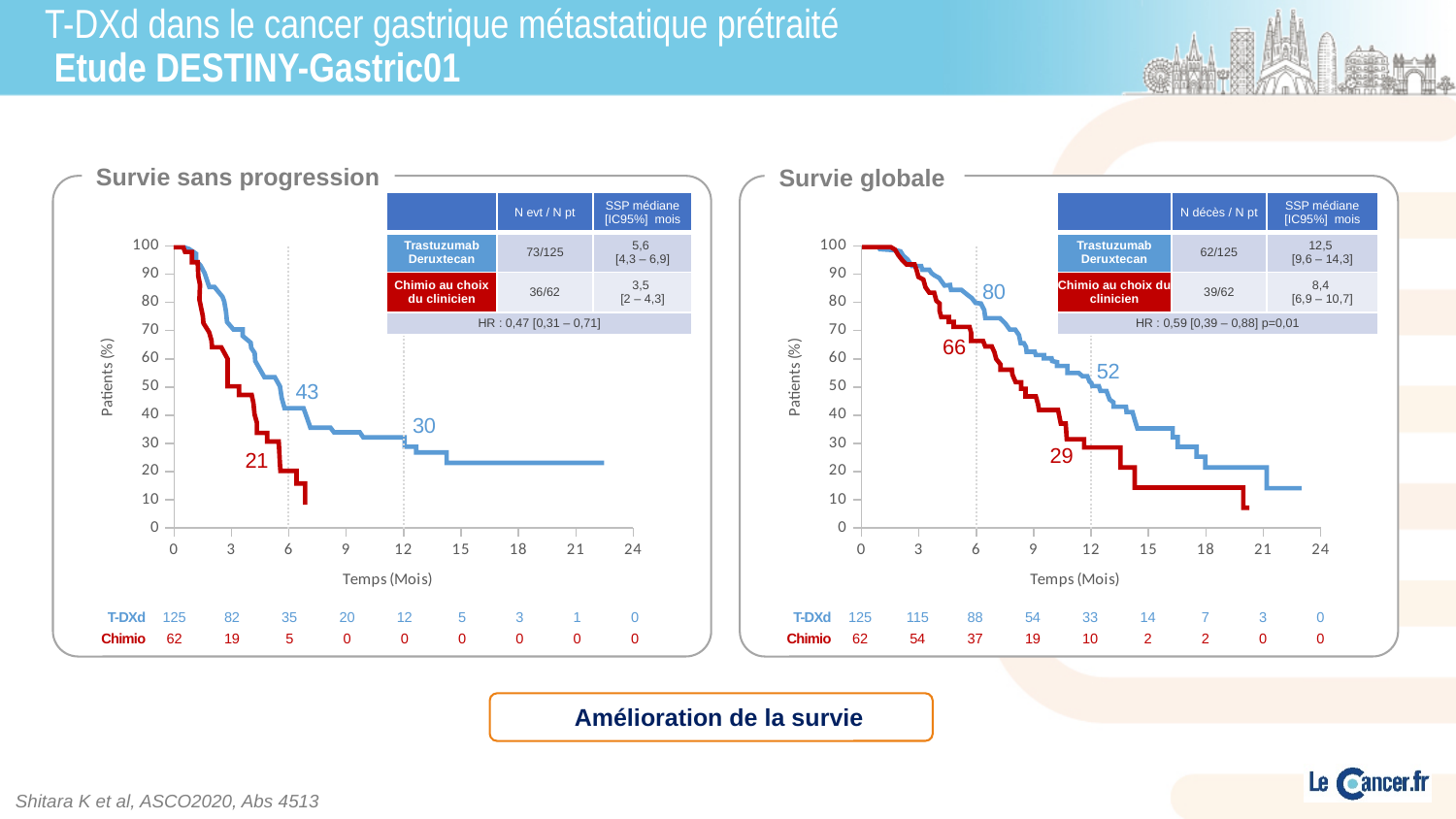
On the 'Survie globale' chart, how many T-DXd patients are at risk at 12 months according to the numbers-at-risk row? 33 On the 'Survie globale' chart, what is the labelled value for the Chimio curve at 12 months? 29 On the 'Survie globale' chart, what is the labelled value for the T-DXd curve at 6 months? 80 On the 'Survie sans progression' chart, what is the difference between the T-DXd and Chimio labelled values at 6 months? 22 On the 'Survie sans progression' chart, what is the median PFS in months for Trastuzumab Deruxtecan shown in the table? 5,6 On the 'Survie sans progression' chart, do the curves rise or fall as time increases along the x axis? fall On the 'Survie sans progression' chart, what is the labelled value for the Chimio curve at 6 months? 21 On the 'Survie globale' chart, what is the hazard ratio shown in the table? 0,59 On the 'Survie sans progression' chart, what is the labelled value for the T-DXd curve at 12 months? 30 On the 'Survie globale' chart, what is the difference between the T-DXd and Chimio labelled values at 12 months? 23 On the 'Survie sans progression' chart, what is the labelled value for the T-DXd curve at 6 months? 43 On the 'Survie globale' chart, which curve has the higher value at 6 months, T-DXd or Chimio? T-DXd